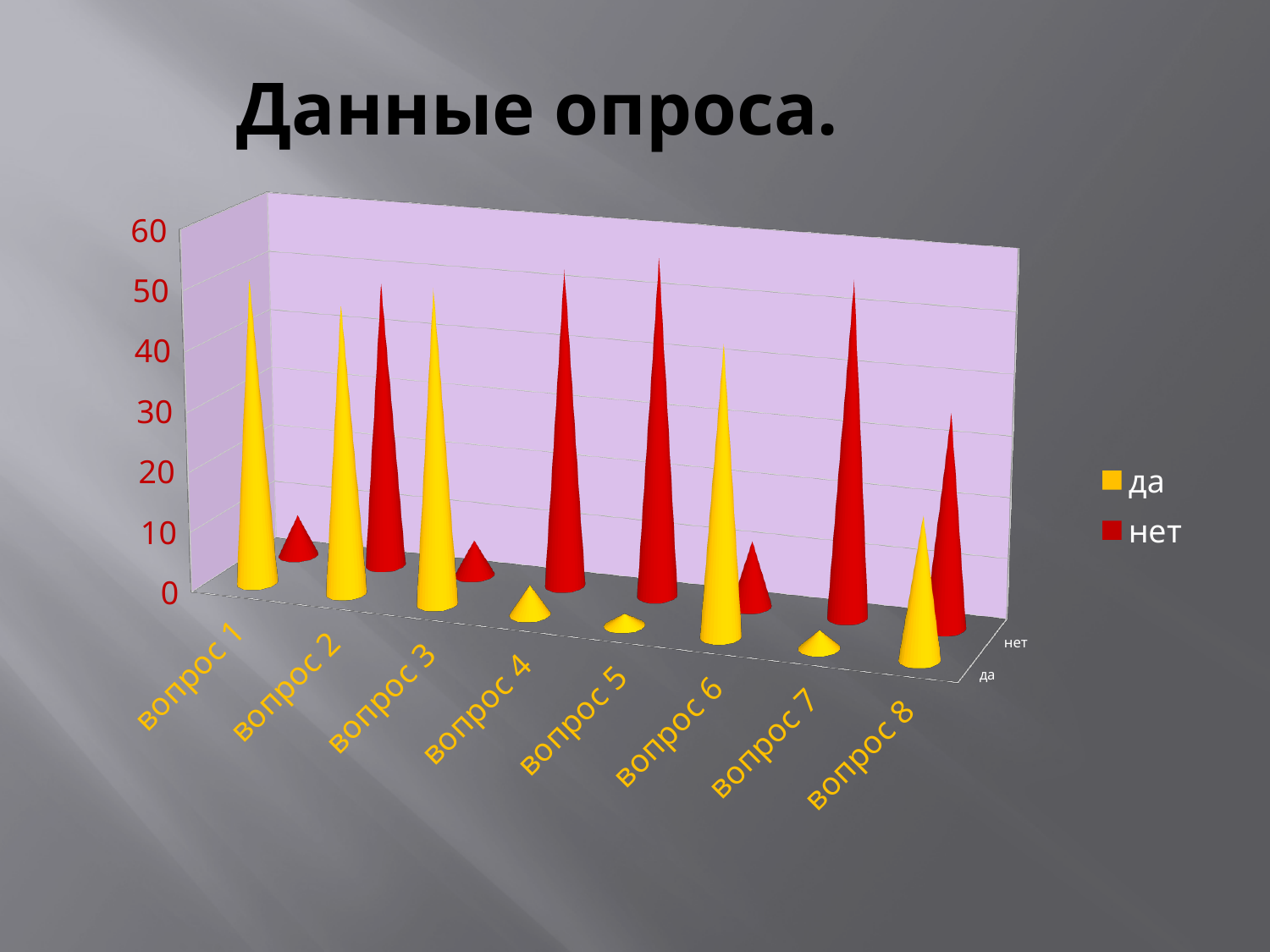
Is the value for "да" at вопрос 7 greater or less than 10? less How many categories (questions) are shown on the x axis? 8 Is the value for "да" at вопрос 1 greater or less than 30? greater What is the title of the chart? Данные опроса. For вопрос 4, which is larger: "да" or "нет"? нет Is the value for "нет" at вопрос 5 greater or less than 30? greater What kind of chart is shown on the slide? bar chart Which colour represents the series "да" in the legend? yellow For вопрос 1, which is larger: "да" or "нет"? да How many series does the legend list? 2 For вопрос 6, which is larger: "да" or "нет"? да